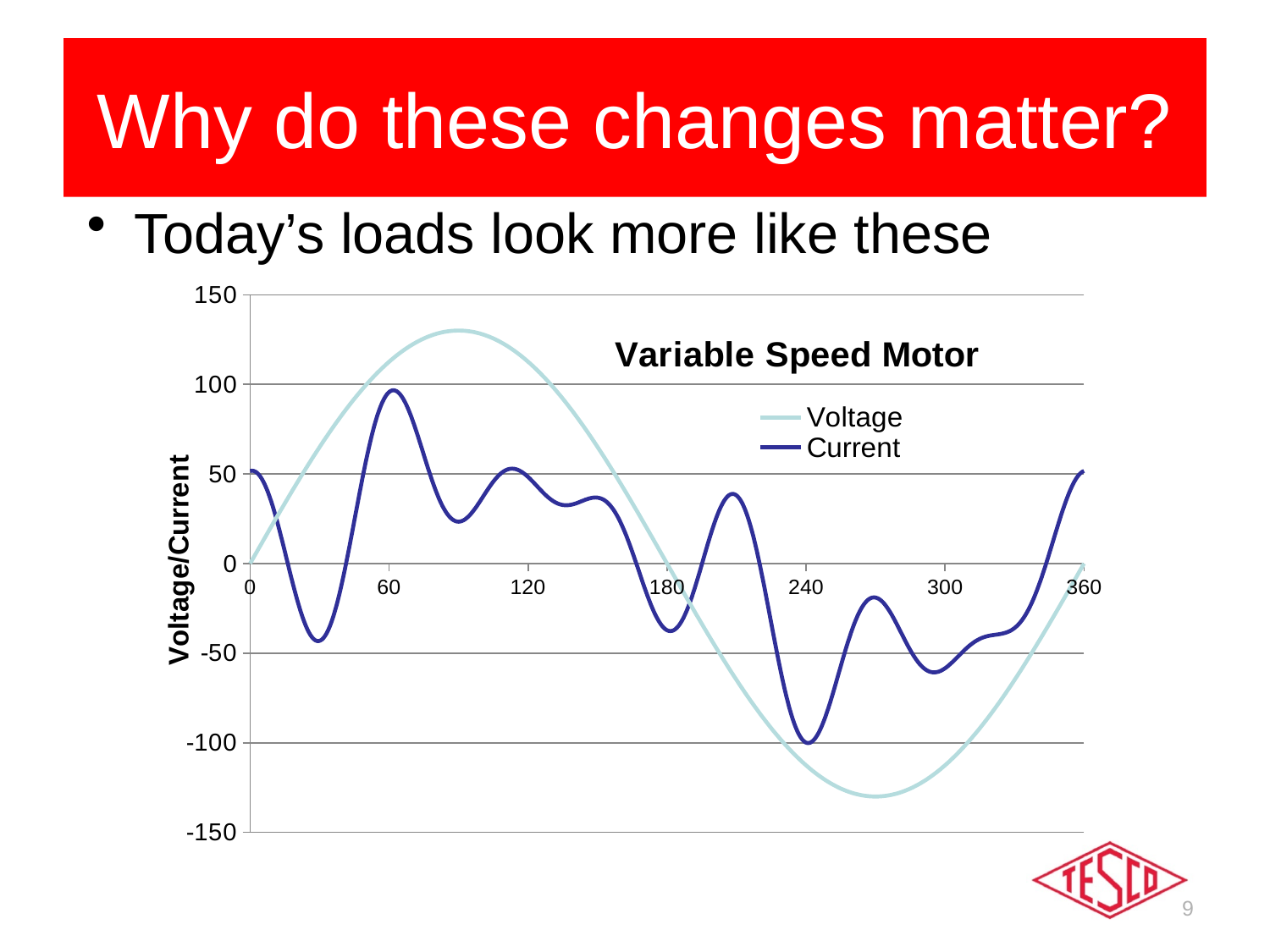
What kind of chart is shown on the slide? line chart What is the value of the Voltage series at 180 on the x axis? 0 Does the Voltage series rise or fall between 90 and 270 on the x axis? fall What is the label on the vertical axis of the chart? Voltage/Current Is the value of the Current series at 270 greater or less than -50? greater Is the value of the Voltage series at 90 greater or less than 100? greater Is the value of the Current series at 180 greater or less than 0? less How many series does the legend list? 2 What is the title of the chart? Variable Speed Motor At 90 on the x axis, which series has the larger value, Voltage or Current? Voltage What is the value of the Voltage series at 360 on the x axis? 0